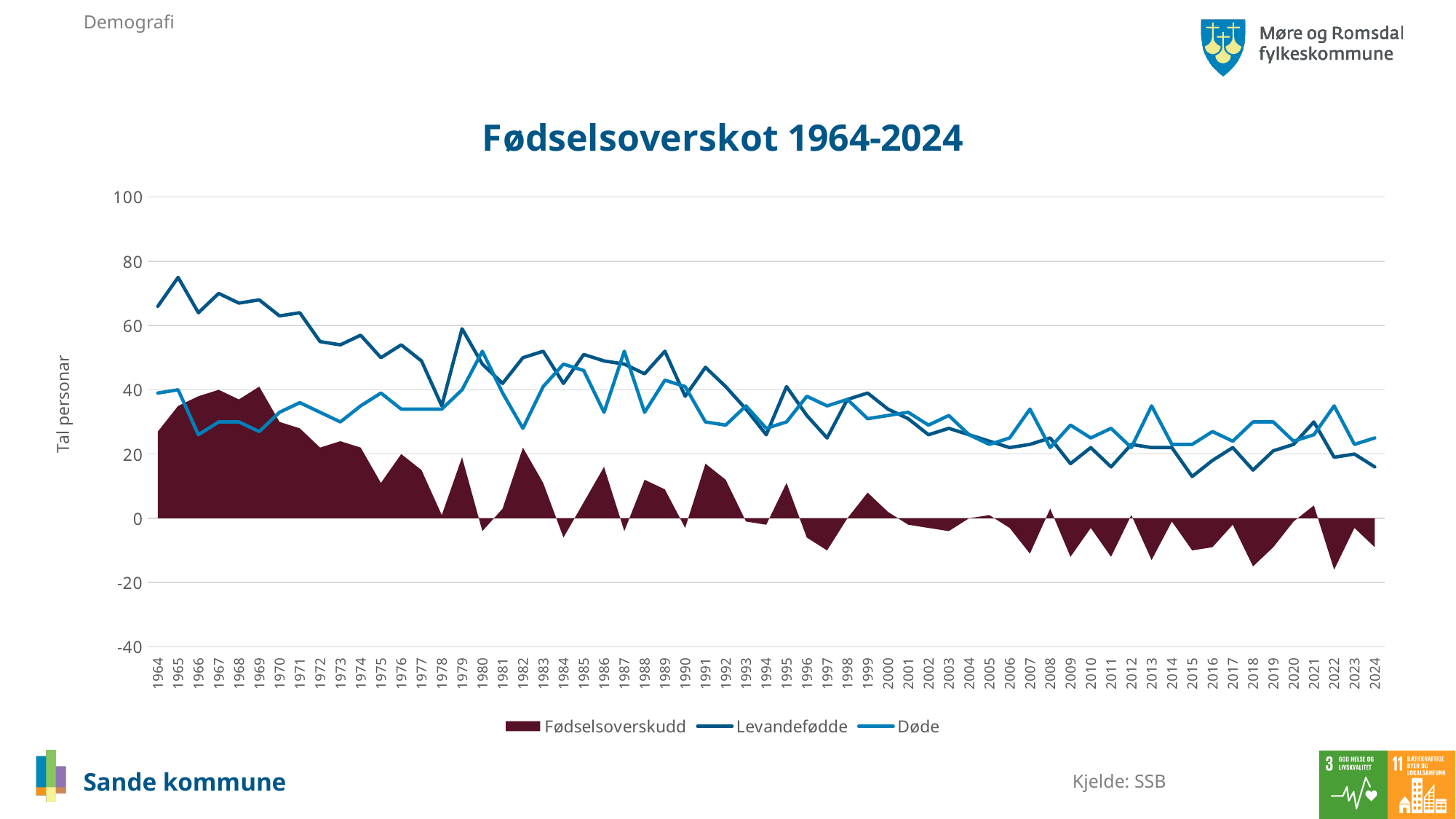
Is the value for Døde in 1964 greater or less than 60? less Is the value for Fødselsoverskudd in 2022 greater or less than 0? less Is the value for Levandefødde in 1965 greater or less than 60? greater In 1965, which is larger: Levandefødde or Døde? Levandefødde How many years are plotted along the x axis? 61 Does the Levandefødde series generally rise or fall from 1964 to 2024? fall What is the label on the vertical axis? Tal personar How many series does the legend list? 3 In 2015, which is larger: Levandefødde or Døde? Døde What is the title of the chart? Fødselsoverskot 1964-2024